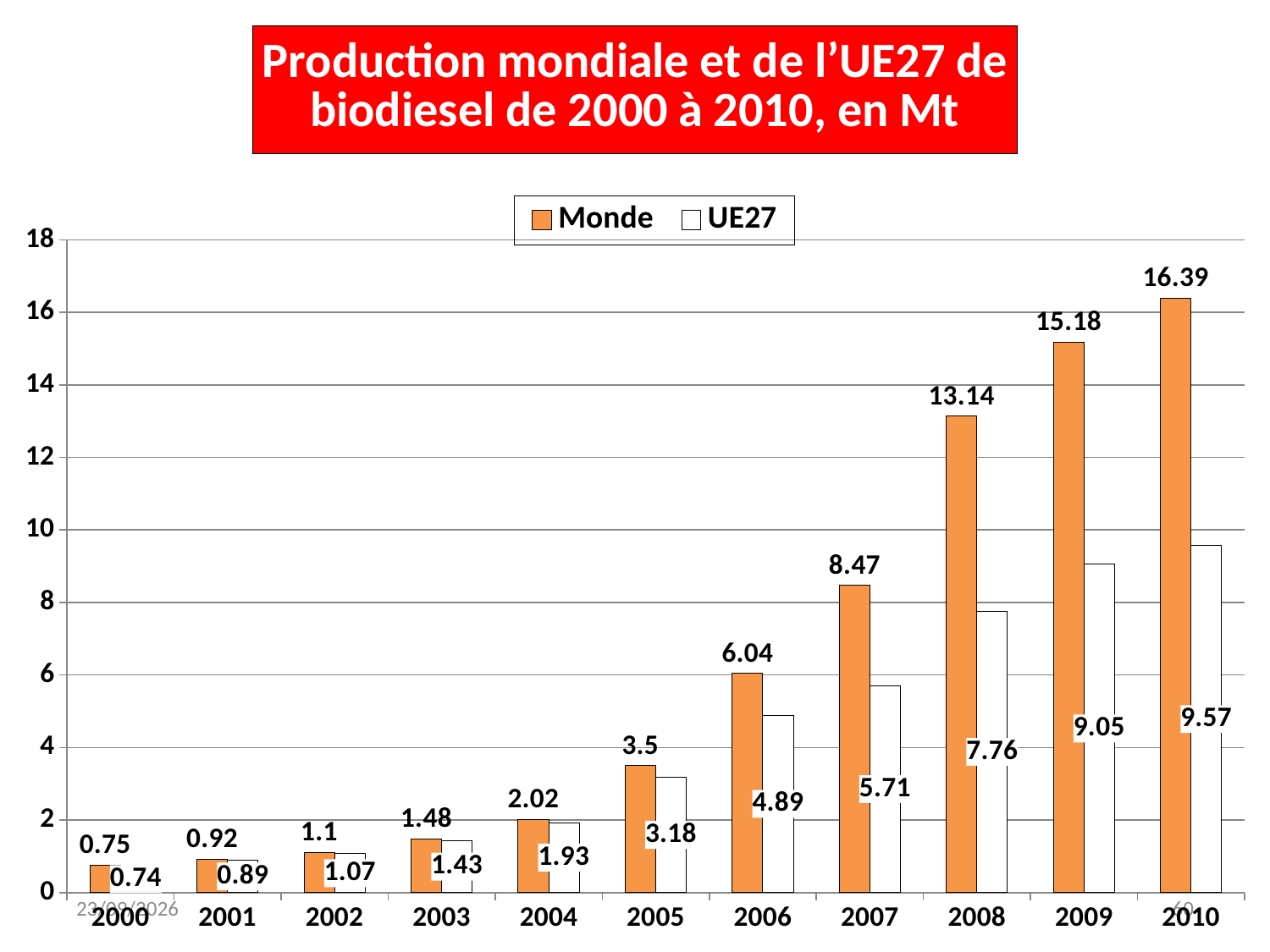
What is the Monde value for 2005? 3.5 Which year has the highest Monde value? 2010 How many series does the legend list? 2 What kind of chart is shown on the slide? Bar chart How many years are shown on the x axis? 11 What is the UE27 value for 2008? 7.76 What is the Monde value for 2010? 16.39 Do the Monde values rise or fall from 2000 to 2010? Rise What is the difference between the Monde and UE27 values in 2010? 6.82 Which year has the lowest UE27 value? 2000 What is the title of the chart? Production mondiale et de l'UE27 de biodiesel de 2000 à 2010, en Mt Which is larger in 2007, the Monde value or the UE27 value? Monde